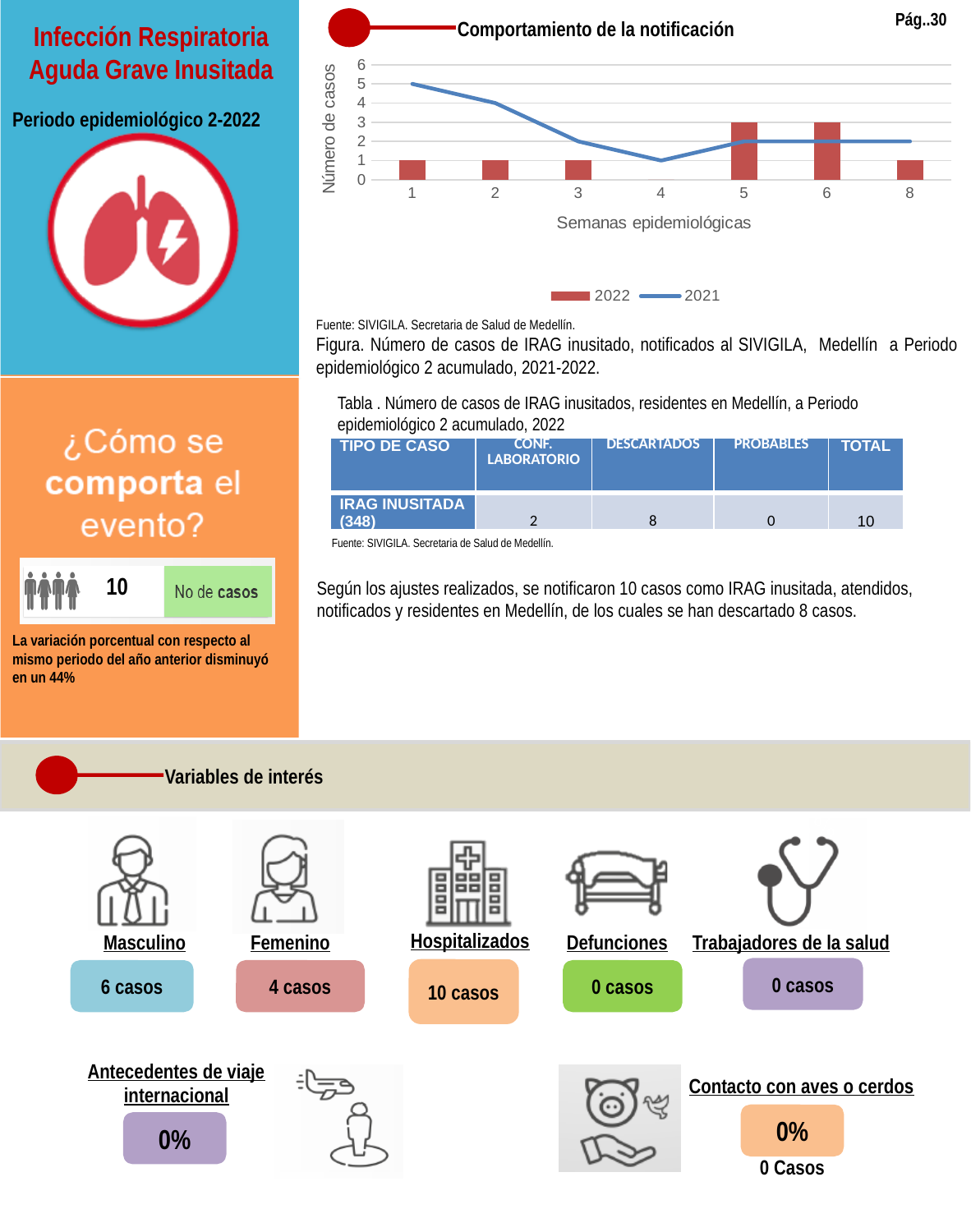
How many series does the legend of the 'Comportamiento de la notificación' chart list? 2 In the 'Comportamiento de la notificación' chart, which series is drawn as bars? 2022 Which two series are listed in the legend of the 'Comportamiento de la notificación' chart? 2022 and 2021 In the 'Comportamiento de la notificación' chart, at which week is the 2021 line lowest? Week 4 In the 'Comportamiento de la notificación' chart, does the 2021 line rise or fall from week 1 to week 4? Fall What kind of chart is shown under 'Comportamiento de la notificación'? A combined bar and line chart In the 'Comportamiento de la notificación' chart, is the 2021 value for week 1 greater or less than 4? greater In the 'Comportamiento de la notificación' chart, is the 2022 value for week 5 greater or less than 2? greater How many epidemiological weeks are shown on the x axis of the 'Comportamiento de la notificación' chart? 7 In the 'Comportamiento de la notificación' chart, at which week is the 2021 line highest? Week 1 In the 'Comportamiento de la notificación' chart, which is larger at week 1: the 2021 value or the 2022 value? 2021 In the 'Comportamiento de la notificación' chart, which week has no 2022 bar? Week 4